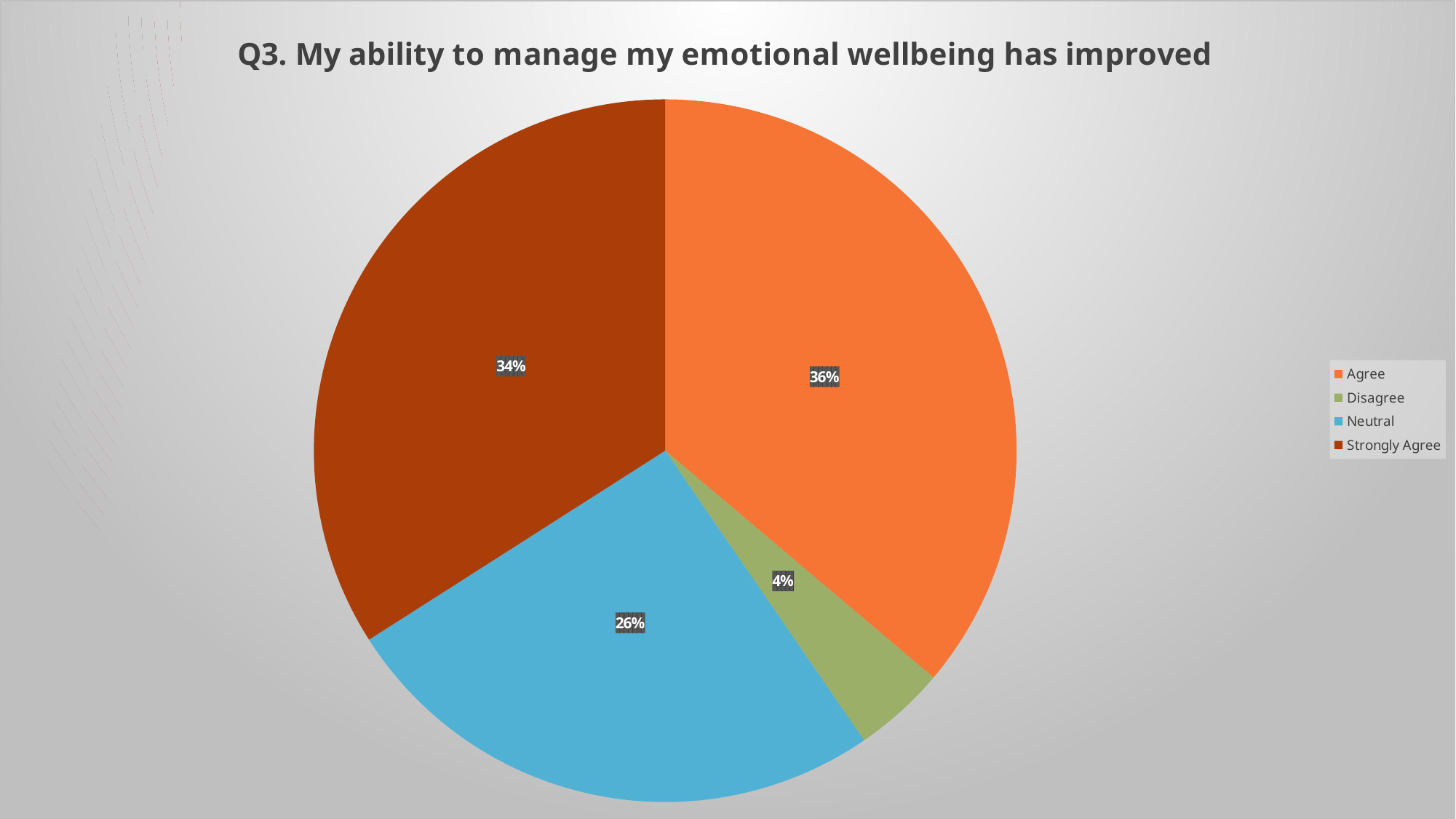
What is the difference in percentage points between Neutral and Disagree? 22 What colour is the Neutral slice? blue What kind of chart is shown on the slide? pie chart What percentage of respondents chose Strongly Agree? 34% Which is larger, the share for Strongly Agree or the share for Neutral? Strongly Agree What percentage of respondents chose Neutral? 26% What percentage of respondents chose Agree? 36% What percentage of respondents chose Disagree? 4% Which response category has the largest share of the pie? Agree What is the title of the chart? Q3. My ability to manage my emotional wellbeing has improved How many categories does the legend list? 4 Which response category has the smallest share of the pie? Disagree